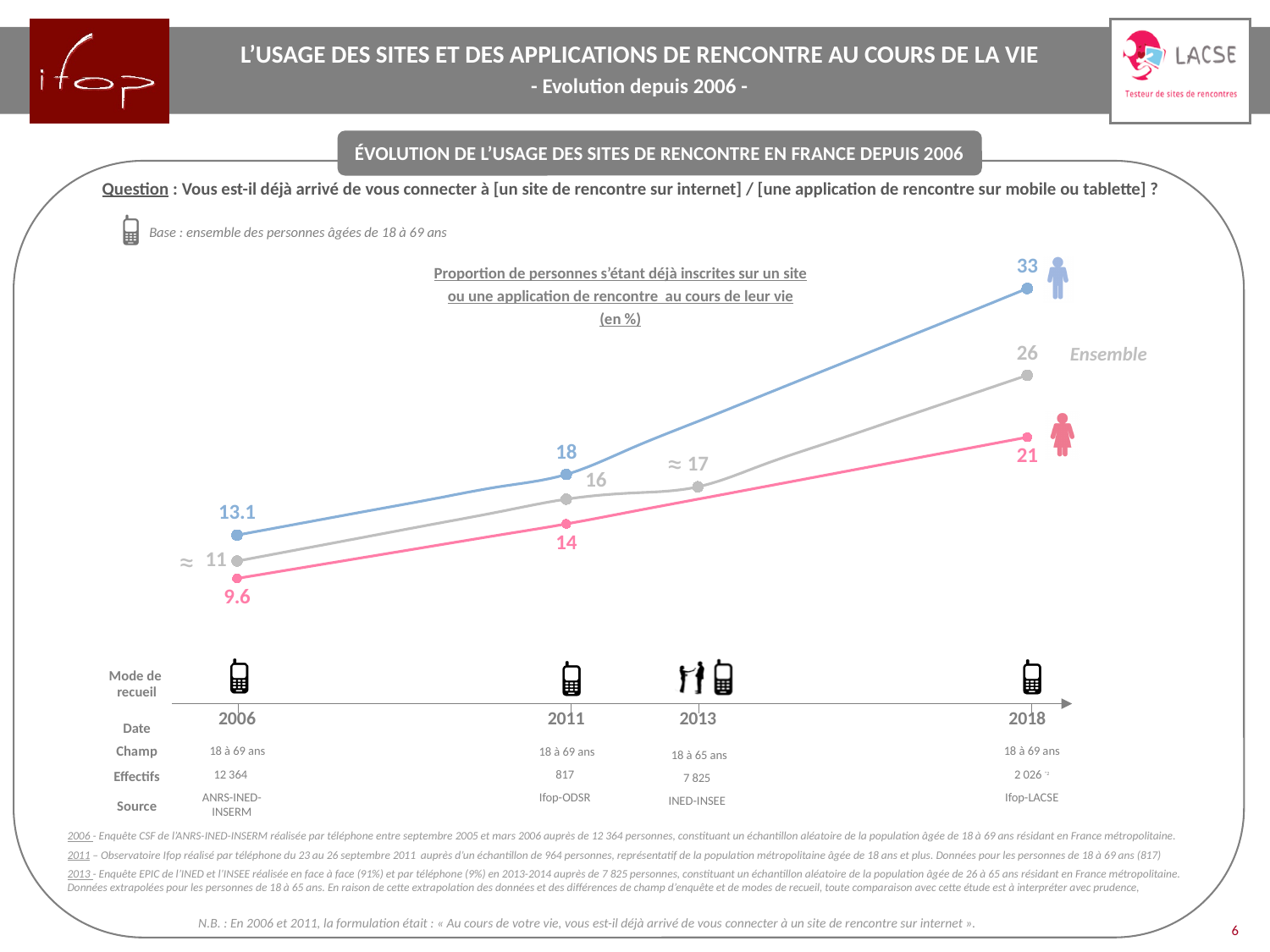
What is the value for the blue line (male icon) in 2018? 33 What is the difference between the blue line (male icon) values in 2011 and 2018? 15 What is the value for the pink line (female icon) in 2018? 21 What is the value for the grey 'Ensemble' line in 2011? 16 What is the value for the blue line (male icon) in 2006? 13.1 Does the grey 'Ensemble' line rise or fall from 2006 to 2018? rise What is the value for the pink line (female icon) in 2006? 9.6 What is the difference between the blue line (male icon) and the pink line (female icon) in 2018? 12 In which year does the blue line (male icon) reach its highest value? 2018 How many years are marked on the x axis of the chart? 4 Which is larger in 2011: the blue line (male icon) or the pink line (female icon)? blue line (male icon) What type of chart is shown on the slide? line chart